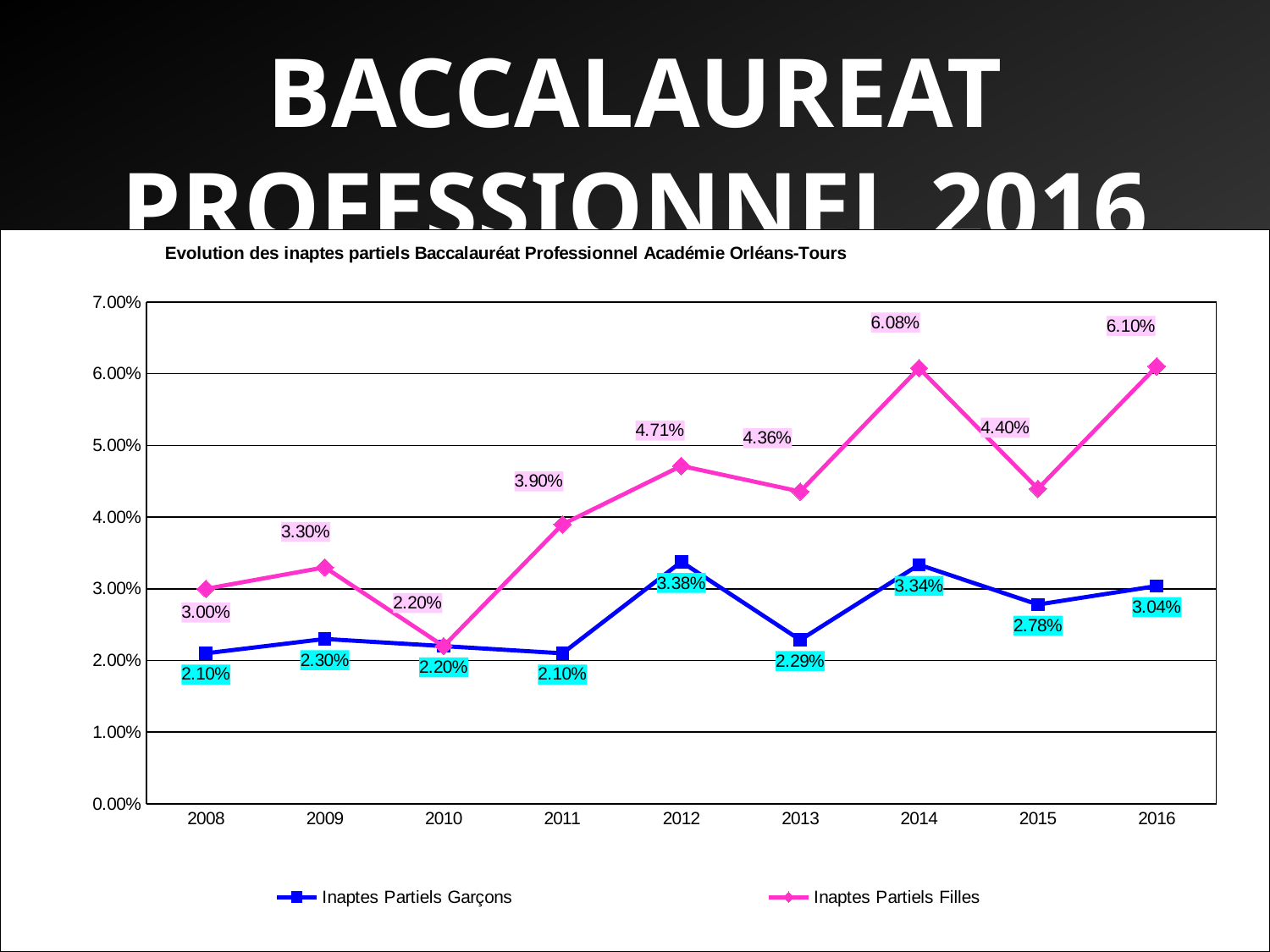
What is the value for Inaptes Partiels Garçons in 2012? 3.38% In which year is the Inaptes Partiels Filles value highest? 2016 What kind of chart is shown on the slide? line chart What is the difference between the Inaptes Partiels Filles and Inaptes Partiels Garçons values in 2016? 3.06% Which series has the larger value in 2013, Inaptes Partiels Garçons or Inaptes Partiels Filles? Inaptes Partiels Filles What is the value for Inaptes Partiels Filles in 2014? 6.08% Is the value for Inaptes Partiels Filles in 2015 greater or less than 4.00%? greater What is the value for Inaptes Partiels Filles in 2011? 3.90% What is the title of the chart? Evolution des inaptes partiels Baccalauréat Professionnel Académie Orléans-Tours How many years are shown on the x axis? 9 How many series does the legend list? 2 In which year is the Inaptes Partiels Filles value lowest? 2010